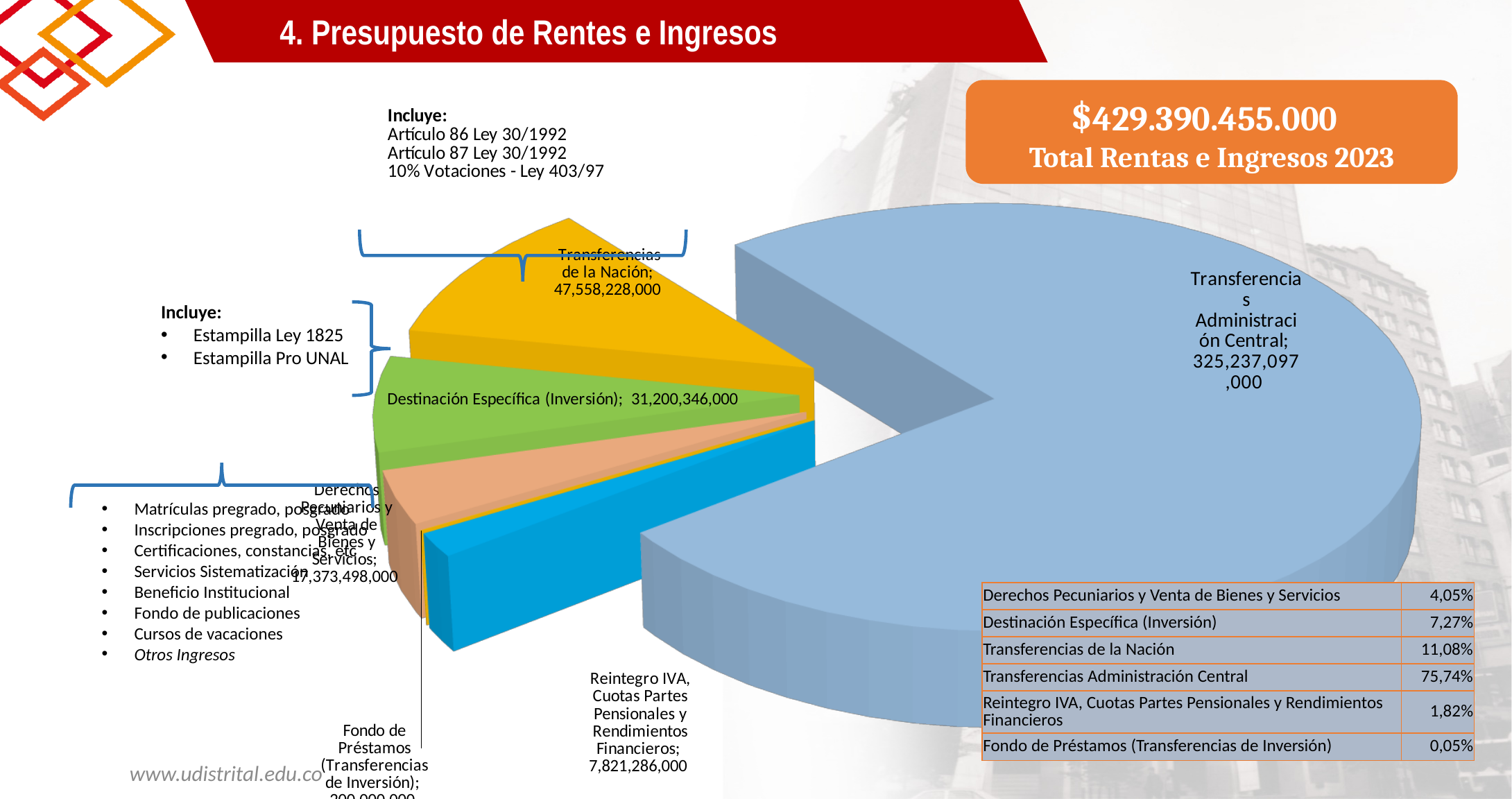
What is the value for Destinación Específica (Inversión) in the pie chart? 31,200,346,000 What is the value for Transferencias Administración Central in the pie chart? 325,237,097,000 How many slices does the pie chart have? 6 According to the table, what share of the total does Transferencias Administración Central represent? 75,74% Which category has the smallest slice in the pie chart? Fondo de Préstamos (Transferencias de Inversión) What is the value for Reintegro IVA, Cuotas Partes Pensionales y Rendimientos Financieros in the pie chart? 7,821,286,000 What is the difference between the values for Transferencias de la Nación and Destinación Específica (Inversión)? 16,357,882,000 What type of chart is shown on the slide? pie chart What is the value for Transferencias de la Nación in the pie chart? 47,558,228,000 Which category has the largest slice in the pie chart? Transferencias Administración Central Which is larger: Destinación Específica (Inversión) or Derechos Pecuniarios y Venta de Bienes y Servicios? Destinación Específica (Inversión) What is the value for Derechos Pecuniarios y Venta de Bienes y Servicios in the pie chart? 17,373,498,000